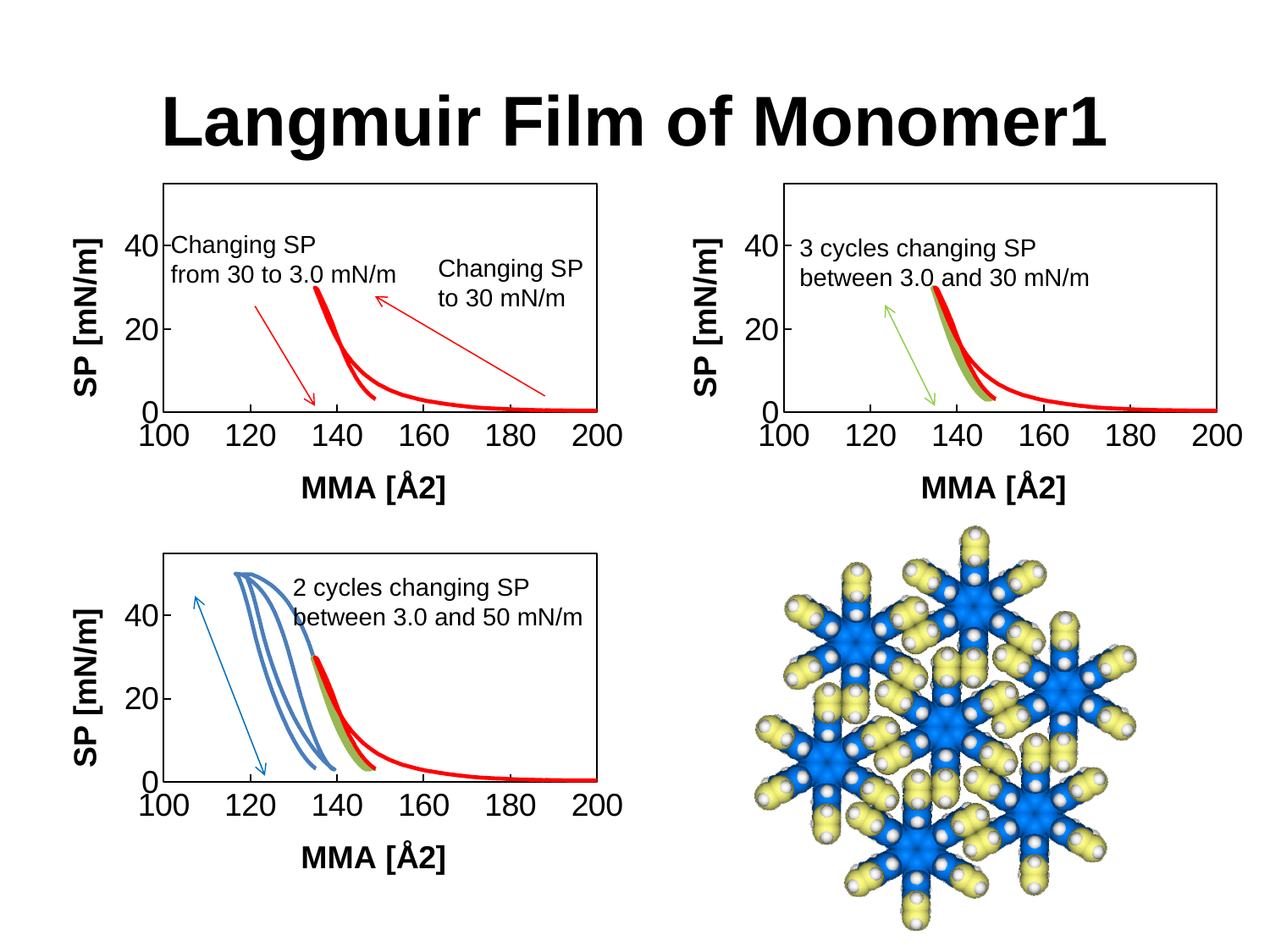
What is the x-axis label of the top-right chart? MMA [Å2] In the bottom-left chart, is the highest SP reached by the red curve greater or less than 40? less In the top-left chart, is the highest SP reached by the red curve greater or less than 40? less In the bottom-left chart, at MMA = 120, is the SP of the blue curves greater or less than 20? greater What is the y-axis label of the bottom-left chart? SP [mN/m] How many line charts are shown on the slide? 3 In the bottom-left chart, does the red curve rise or fall as MMA increases from 140 to 200? fall What kind of chart is the top-left chart on the slide? line chart In the top-left chart, does SP rise or fall as MMA increases along the x axis? fall In the bottom-left chart, which reaches a higher SP, the blue curves or the red curve? blue curves